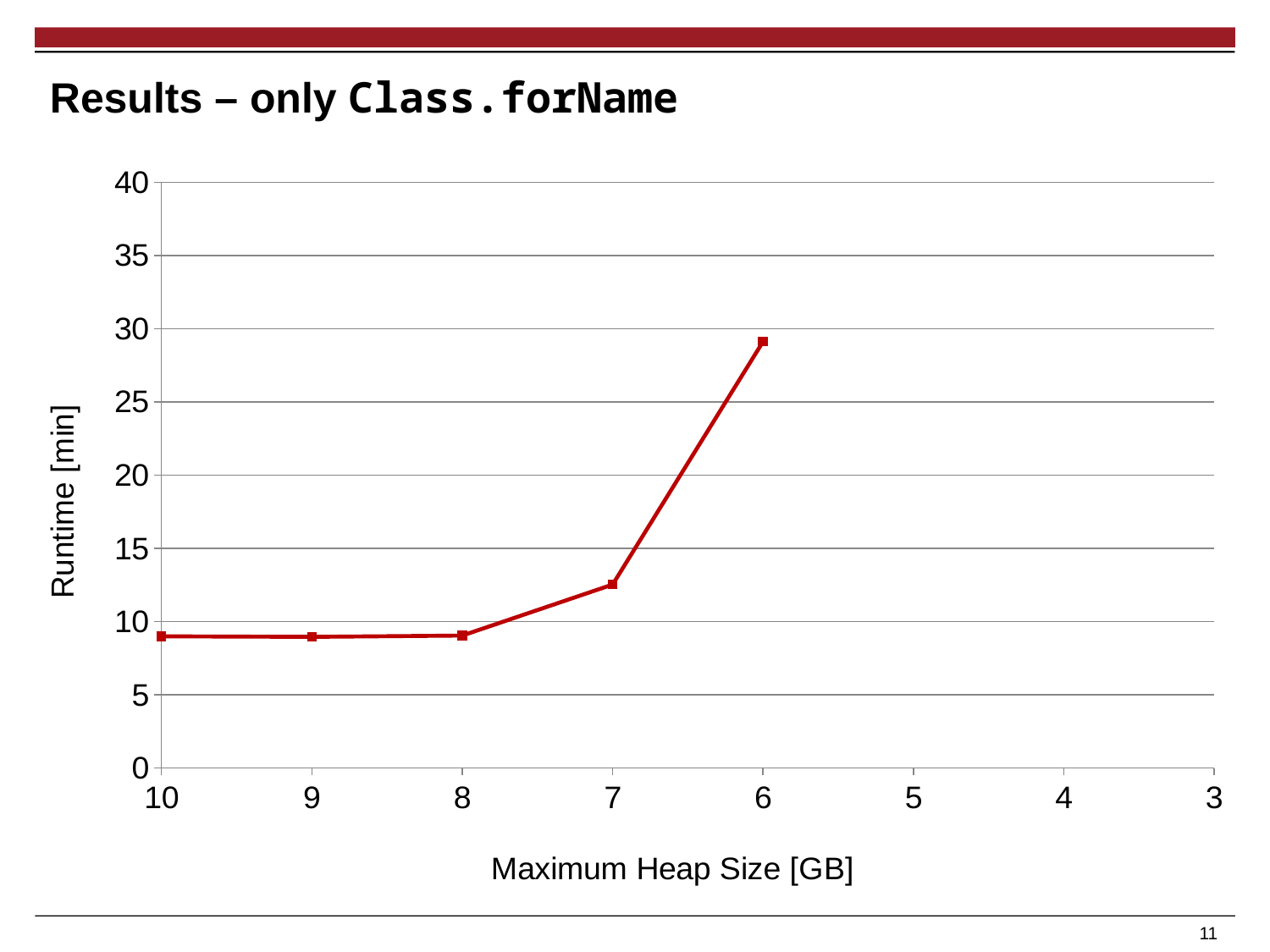
What kind of chart is shown on the slide? line chart What is the label of the x axis? Maximum Heap Size [GB] Does the runtime rise or fall as you move from left to right along the x axis (from 10 GB toward 6 GB)? rise Is the runtime at a maximum heap size of 10 GB greater or less than 10 minutes? less Is the runtime at a maximum heap size of 6 GB greater or less than 25 minutes? greater Which has the larger runtime: a maximum heap size of 6 GB or 8 GB? 6 GB How many data points are plotted on the line? 5 Is the runtime at a maximum heap size of 7 GB greater or less than 15 minutes? less At which maximum heap size is the runtime highest? 6 GB What is the label of the y axis? Runtime [min]